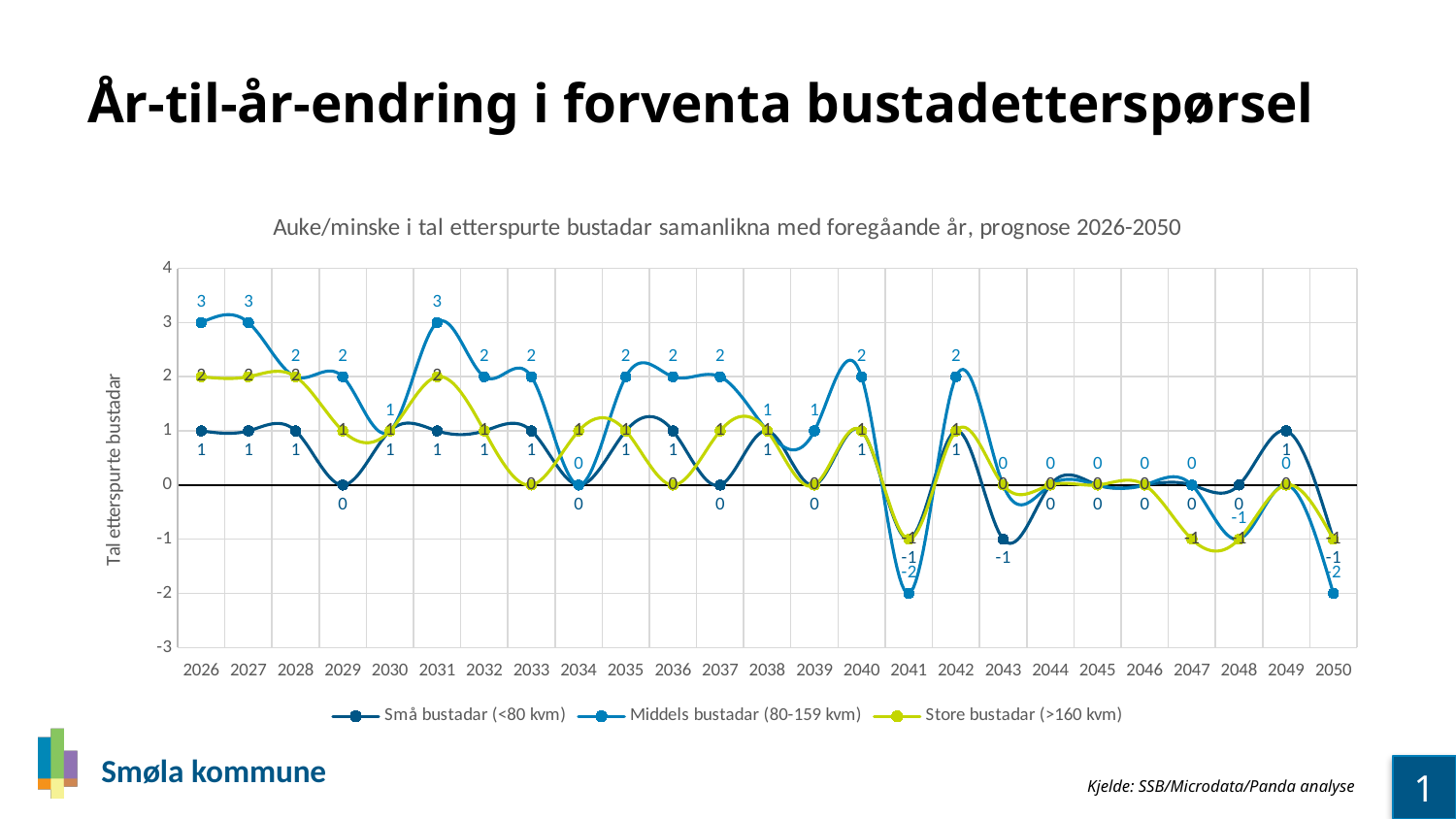
What is the value for Middels bustadar (80-159 kvm) in 2026? 3 In 2026, which series has the larger value: Små bustadar (<80 kvm) or Middels bustadar (80-159 kvm)? Middels bustadar (80-159 kvm) What kind of chart is shown on the slide? Line chart What is the value for Små bustadar (<80 kvm) in 2043? -1 Is the Middels bustadar (80-159 kvm) value in 2050 higher or lower than in 2026? Lower What is the value for Middels bustadar (80-159 kvm) in 2041? -2 How many series does the legend list? 3 What is the value for Middels bustadar (80-159 kvm) in 2031? 3 What is the difference between the Middels bustadar (80-159 kvm) value and the Små bustadar (<80 kvm) value in 2026? 2 What is the lowest value reached by the Middels bustadar (80-159 kvm) series? -2 What is the label on the vertical axis of the chart? Tal etterspurte bustadar How many years are plotted along the x axis? 25